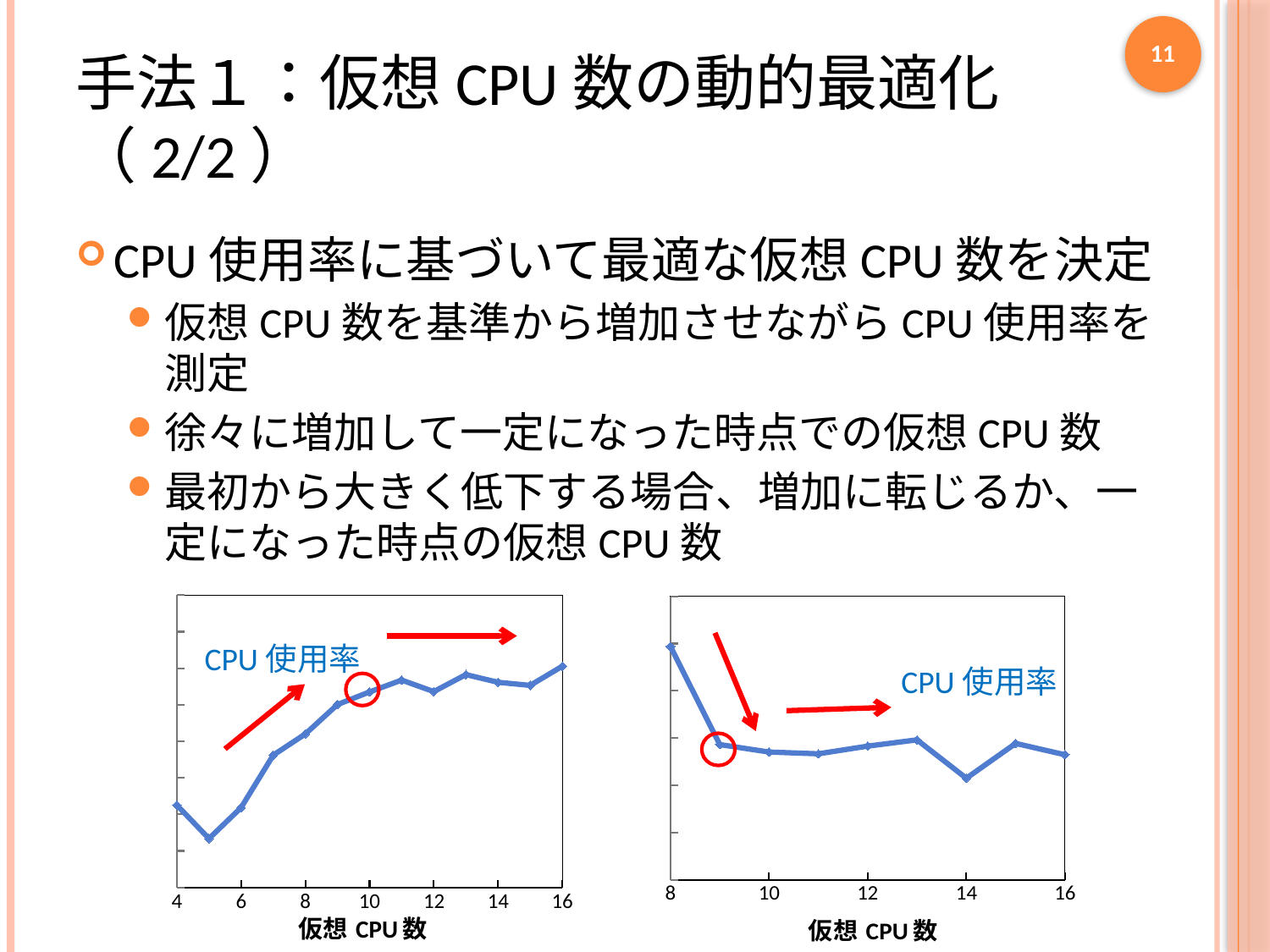
In the right chart, at which 仮想 CPU 数 value is CPU 使用率 lowest? 14 In the left chart, how many data points are plotted on the line? 13 What kind of chart is the left chart on the slide? line chart In the right chart, is CPU 使用率 higher at 仮想 CPU 数 = 9 or at 仮想 CPU 数 = 14? 9 What kind of chart is the right chart on the slide? line chart What is the x-axis title of the left chart? 仮想 CPU 数 In the right chart, how many data points are plotted on the line? 9 In the left chart, is CPU 使用率 higher at 仮想 CPU 数 = 8 or at 仮想 CPU 数 = 12? 12 In the right chart, does CPU 使用率 rise or fall as 仮想 CPU 数 increases from 8 to 9? fall In the left chart, at which 仮想 CPU 数 value is CPU 使用率 lowest? 5 In the left chart, does CPU 使用率 generally rise or fall as 仮想 CPU 数 increases from 5 to 11? rise In the right chart, at which 仮想 CPU 数 value is CPU 使用率 highest? 8